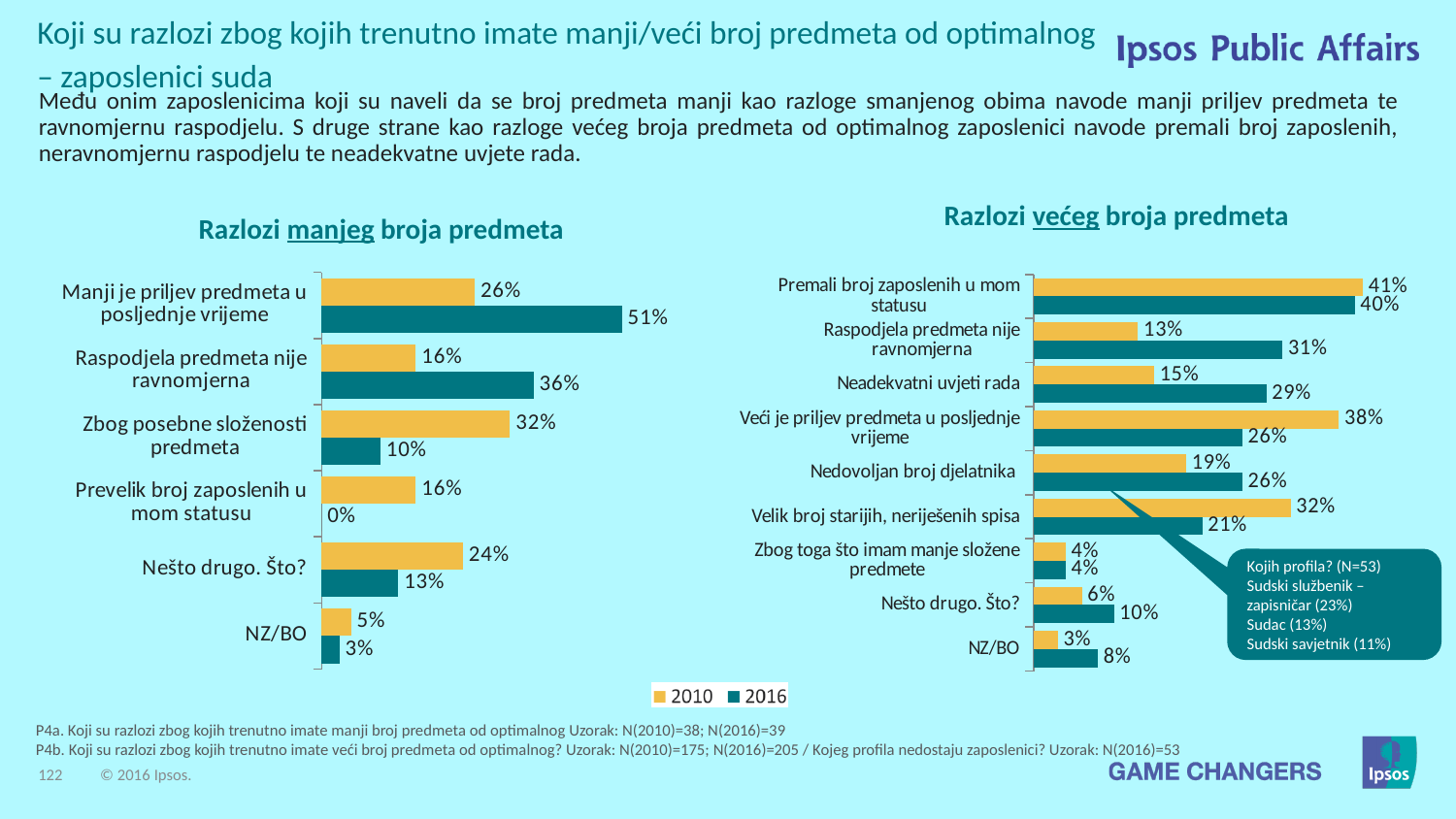
In the chart 'Razlozi manjeg broja predmeta', what is the 2010 value for 'Zbog posebne složenosti predmeta'? 32% In the chart 'Razlozi manjeg broja predmeta', what is the 2016 value for 'Manji je priljev predmeta u posljednje vrijeme'? 51% In the chart 'Razlozi manjeg broja predmeta', how many categories are shown? 6 In the chart 'Razlozi većeg broja predmeta', what is the 2010 value for 'Premali broj zaposlenih u mom statusu'? 41% In the chart 'Razlozi većeg broja predmeta', how many categories are shown? 9 In the chart 'Razlozi većeg broja predmeta', which is larger for 'Velik broj starijih, neriješenih spisa': the 2010 value or the 2016 value? 2010 In the chart 'Razlozi manjeg broja predmeta', what is the difference between the 2016 and 2010 values for 'Raspodjela predmeta nije ravnomjerna'? 20 percentage points How many series does the legend list for the charts on the slide? 2 In the chart 'Razlozi većeg broja predmeta', what is the 2016 value for 'Neadekvatni uvjeti rada'? 29% What type of chart is 'Razlozi većeg broja predmeta'? Bar chart In the chart 'Razlozi manjeg broja predmeta', which category has the lowest 2016 value? Prevelik broj zaposlenih u mom statusu In the chart 'Razlozi većeg broja predmeta', which category has the highest 2016 value? Premali broj zaposlenih u mom statusu